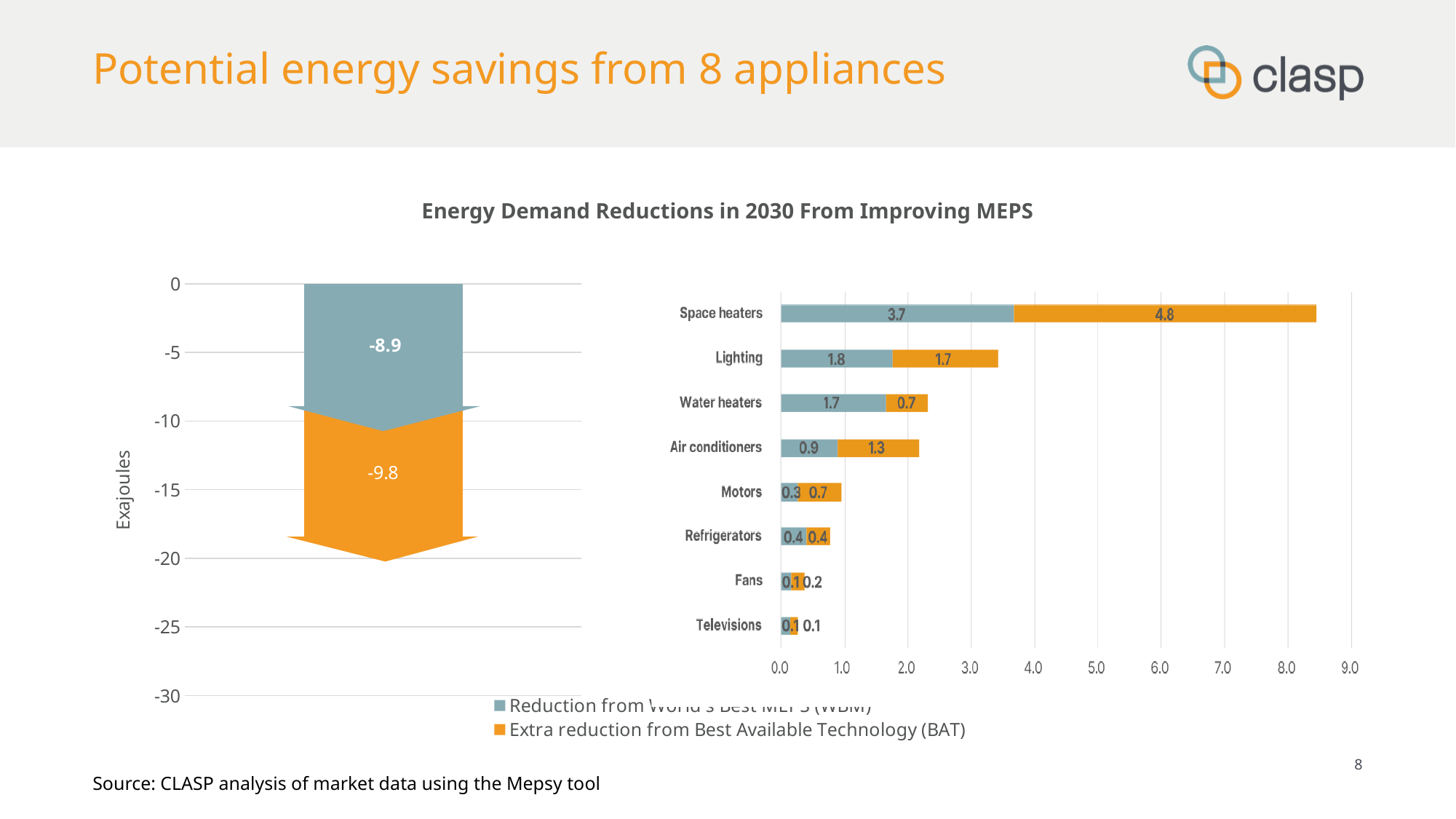
How many series does the legend list for the Energy Demand Reductions in 2030 From Improving MEPS chart? 2 How many appliance categories are shown in the Energy Demand Reductions in 2030 From Improving MEPS chart? 8 In the Energy Demand Reductions in 2030 From Improving MEPS chart, which has the larger WBM reduction: Water heaters or Air conditioners? Water heaters In the chart on the left of the slide, what value is shown for the extra reduction from Best Available Technology (BAT) in exajoules? -9.8 In the chart on the left of the slide, what value is shown for the reduction from World's Best MEPS (WBM) in exajoules? -8.9 In the Energy Demand Reductions in 2030 From Improving MEPS chart, what is the total reduction for Space heaters (WBM plus BAT)? 8.5 In the Energy Demand Reductions in 2030 From Improving MEPS chart, what is the extra reduction from Best Available Technology (BAT) for Lighting? 1.7 What kind of chart is the Energy Demand Reductions in 2030 From Improving MEPS chart on the right? Stacked horizontal bar chart In the Energy Demand Reductions in 2030 From Improving MEPS chart, what is the reduction from World's Best MEPS (WBM) for Space heaters? 3.7 In the Energy Demand Reductions in 2030 From Improving MEPS chart, how much larger is the BAT extra reduction than the WBM reduction for Space heaters? 1.1 In the Energy Demand Reductions in 2030 From Improving MEPS chart, what is the total reduction for Lighting (WBM plus BAT)? 3.5 In the Energy Demand Reductions in 2030 From Improving MEPS chart, which appliance has the largest total reduction? Space heaters